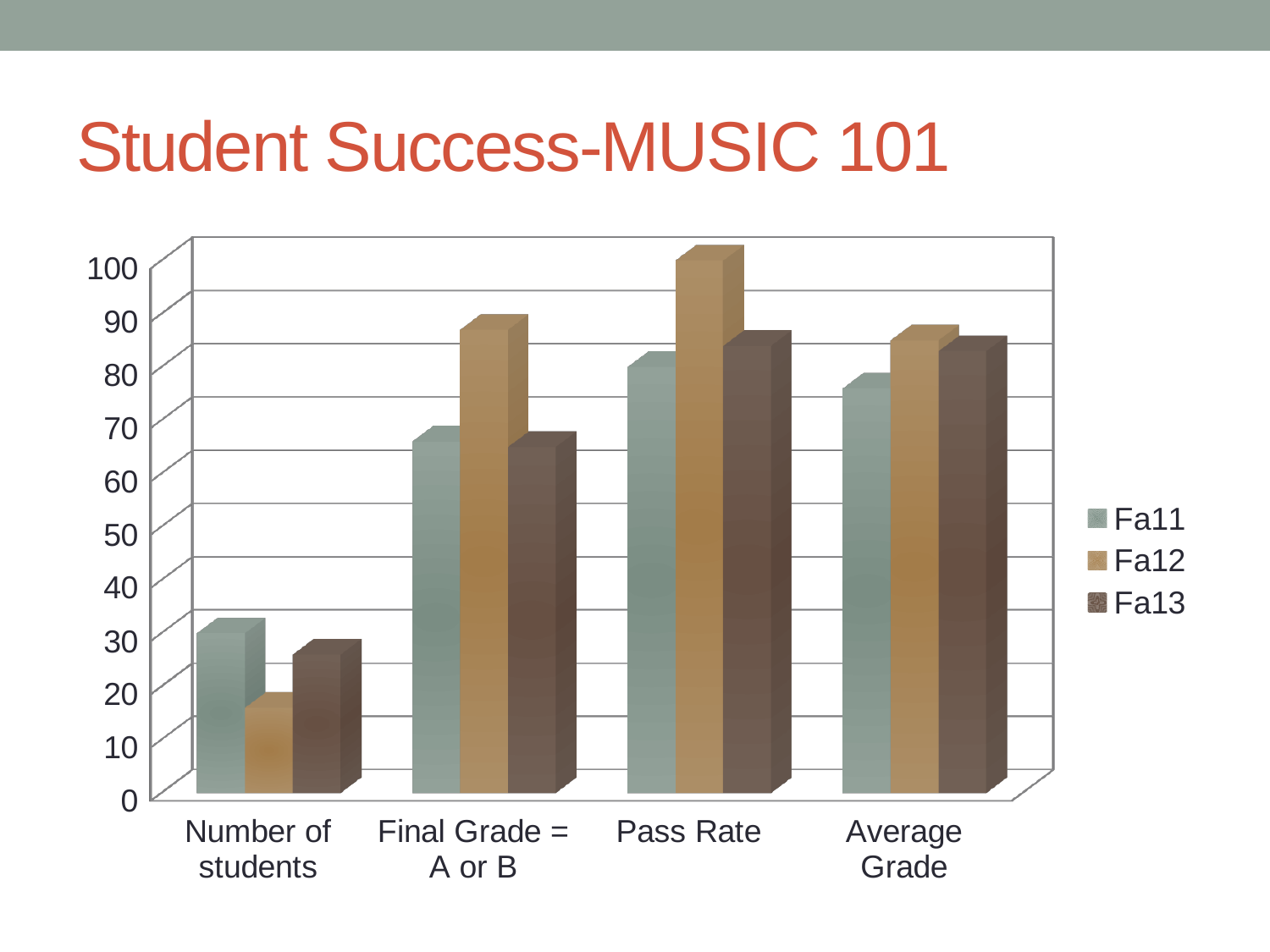
Which is larger for Number of students, Fa11 or Fa13? Fa11 What is the title of the slide? Student Success-MUSIC 101 What kind of chart is shown on the slide? bar chart Which is larger for Final Grade = A or B, Fa11 or Fa12? Fa12 Is the Fa13 value for Final Grade = A or B greater or less than 70? less Which series has the highest value for Final Grade = A or B? Fa12 Which series are listed in the legend? Fa11, Fa12, Fa13 Which series has the lowest Number of students? Fa12 How many categories are shown on the x axis? 4 How many series does the legend list? 3 Is the Fa12 value for Pass Rate greater or less than 90? greater Which series has the highest Pass Rate? Fa12